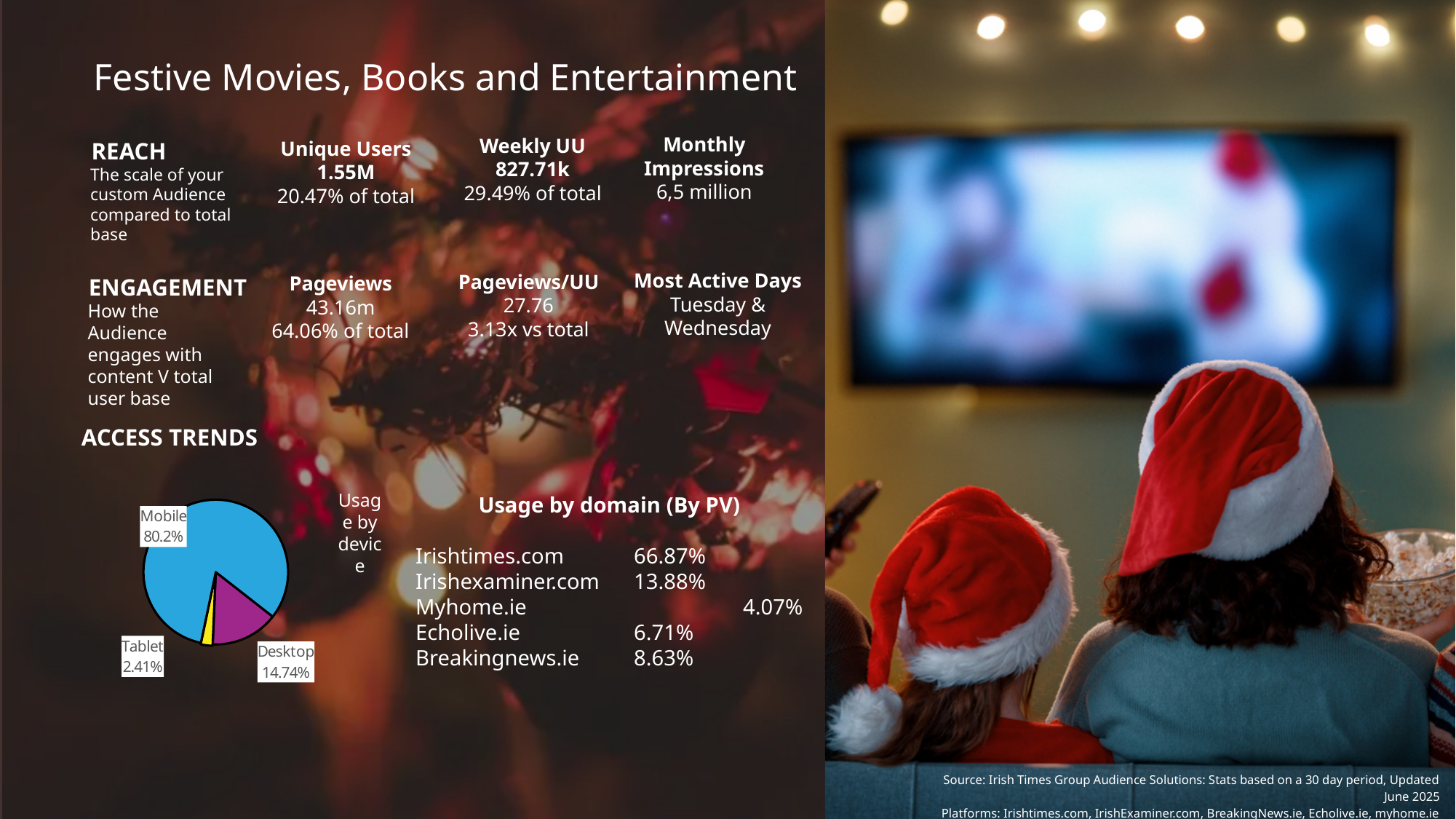
What percentage of usage by device is Desktop? 14.74% What type of chart is used to show usage by device? Pie chart What percentage of usage by device is Mobile? 80.2% Which device has the smallest share of usage in the pie chart? Tablet What share of the pie does the Desktop slice take? 14.74% How many device categories are shown in the pie chart? 3 Which has a larger share of usage, Desktop or Tablet? Desktop What is the difference in percentage points between Desktop and Tablet usage? 12.33 What is the difference in percentage points between Mobile and Desktop usage? 65.46 What percentage of usage by device is Tablet? 2.41% Which device has the largest share of usage in the pie chart? Mobile What colour is the Mobile slice in the pie chart? Blue